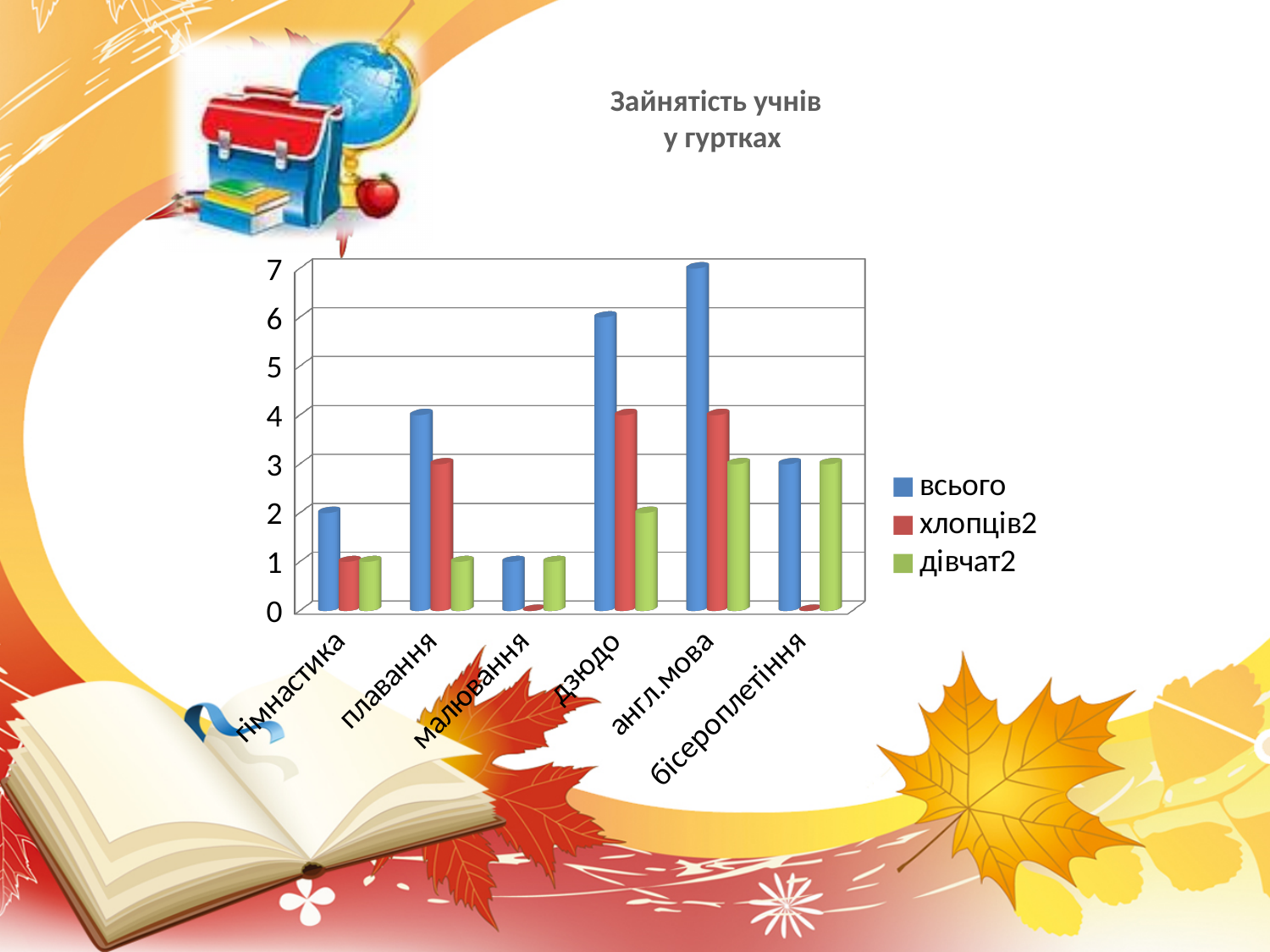
What kind of chart is shown on the slide? bar chart Is the value for дівчат2 in the category дзюдо greater or less than 3? less What is the value for всього in the category англ.мова? 7 How many series does the legend list? 3 What is the value for всього in the category дзюдо? 6 Which category has the lowest value for the series всього? малювання Is the value for всього in the category плавання greater or less than 3? greater Which is larger: the value for всього in дзюдо or the value for всього in бісероплетіння? дзюдо Which series is shown in blue in the legend? всього What is the title of the chart? Зайнятість учнів у гуртках How many categories are shown on the x axis? 6 Which category has the highest value for the series всього? англ.мова